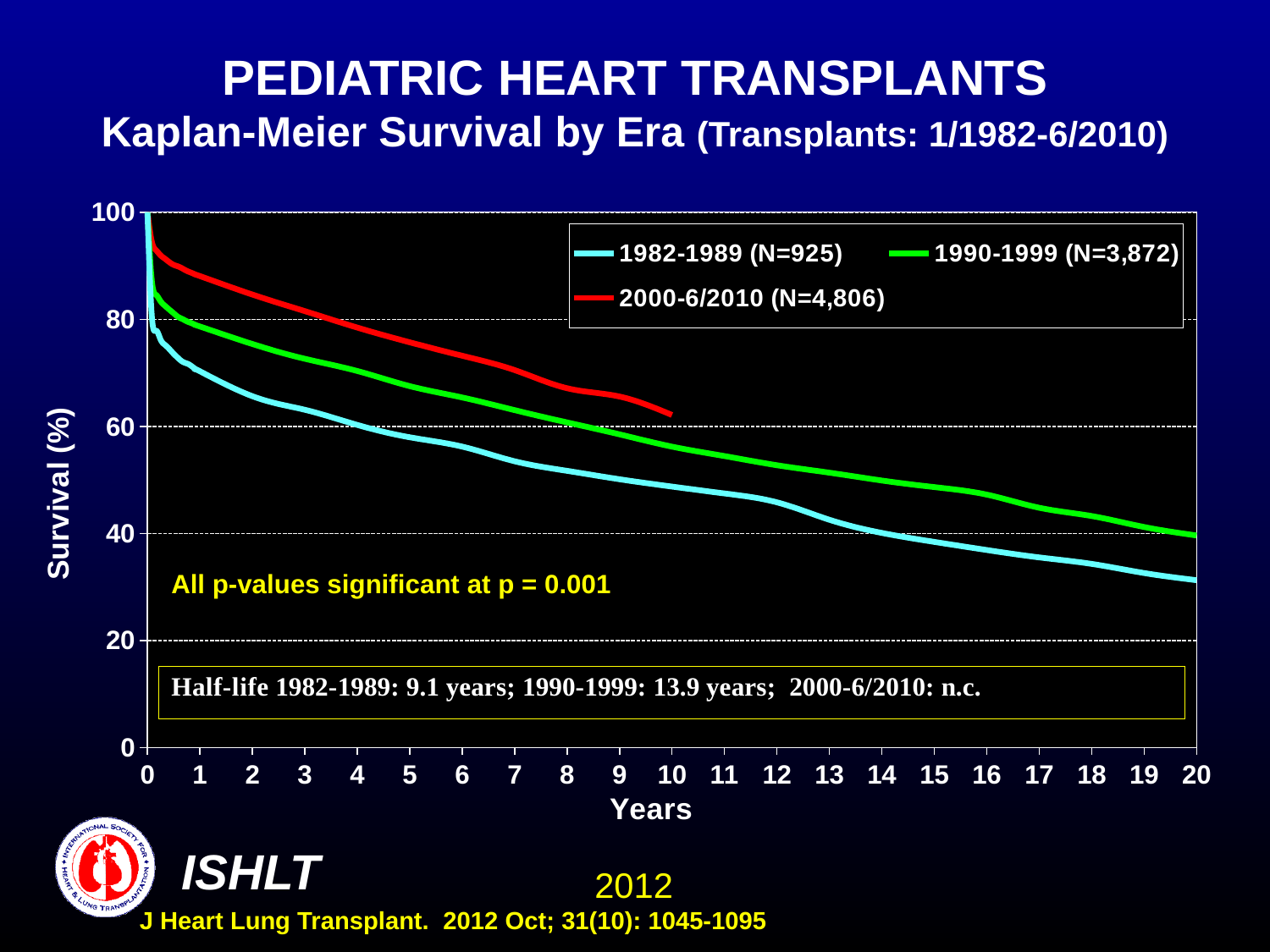
What half-life is reported for the 1990-1999 era? 13.9 years Do the survival curves rise or fall as years since transplant increase? fall How many series does the legend list? 3 What kind of chart is shown on the slide? line chart What is the N shown in the legend for the 2000-6/2010 era? N=4,806 Which era has the lowest survival curve throughout the chart? 1982-1989 At 5 years, which era has higher survival: 1982-1989 or 2000-6/2010? 2000-6/2010 Is the survival for the 1982-1989 era at 20 years greater or less than 40? less Is the survival for the 2000-6/2010 era at 5 years greater or less than 60? greater Is the survival for the 1990-1999 era at 15 years greater or less than 60? less Which era has the highest survival at 10 years? 2000-6/2010